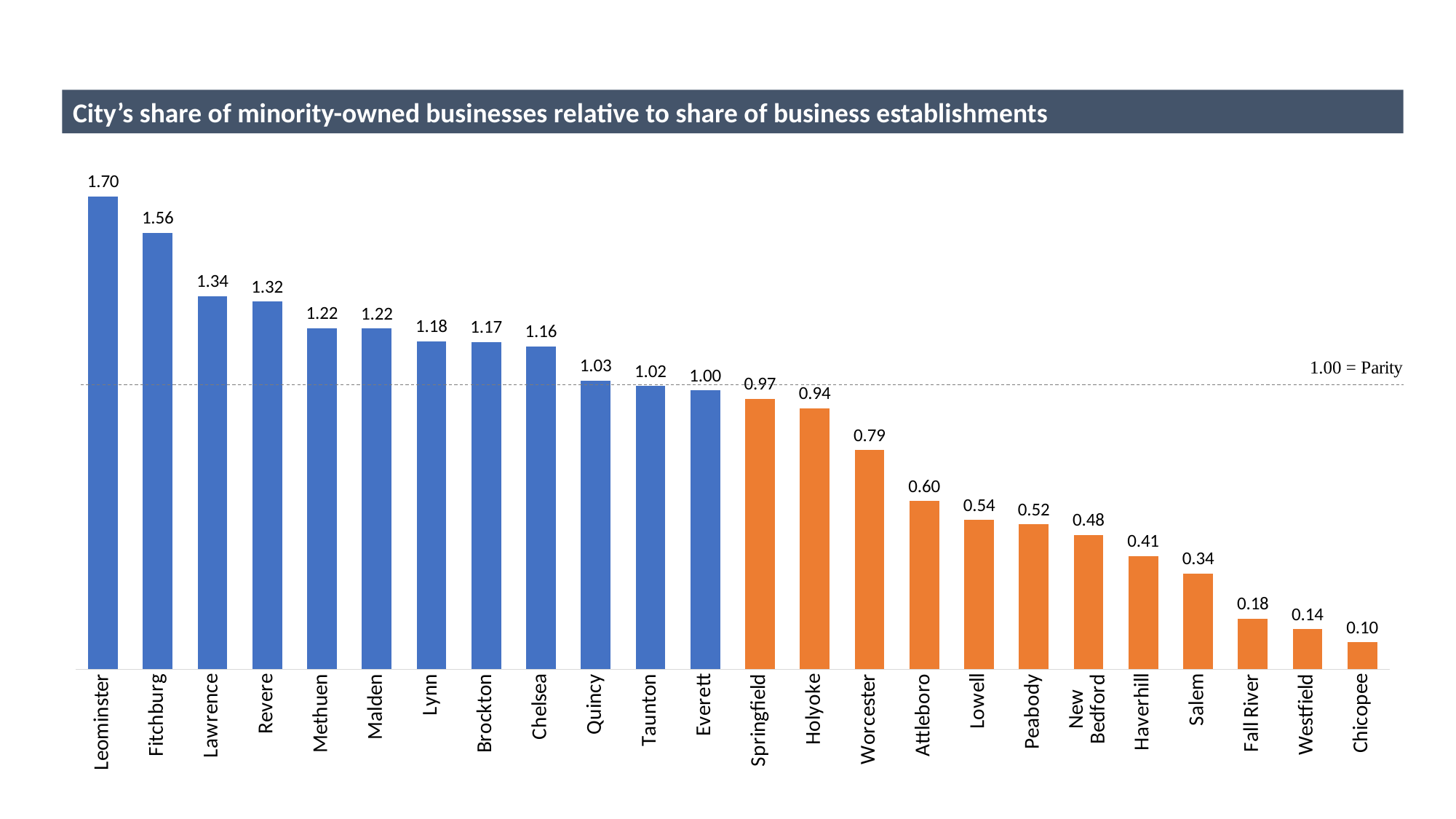
What kind of chart is shown on the slide? Bar chart How many cities are shown on the chart? 24 Which has a larger value, Springfield or Holyoke? Springfield What value does the dashed horizontal line represent? 1.00 = Parity How many cities are shown with orange bars? 12 What is the value for New Bedford? 0.48 Which city has the highest value? Leominster What is the value for Leominster? 1.70 Which city has the lowest value? Chicopee Do the values rise or fall from left to right along the x axis? Fall What is the difference between the values for Fitchburg and Lawrence? 0.22 What is the value for Worcester? 0.79